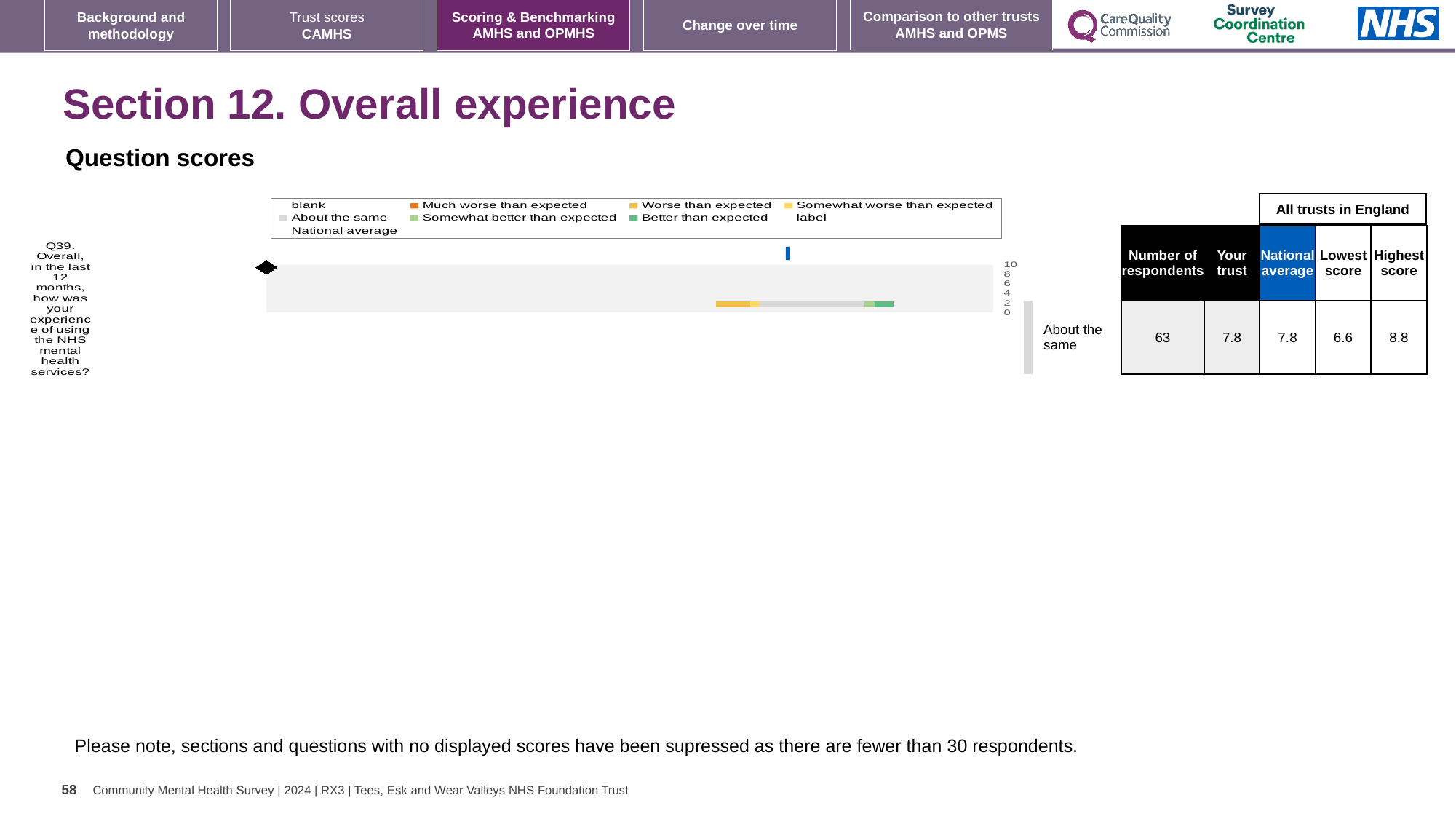
Which question number is plotted in the question scores chart? Q39 What is the national average score for Q39? 7.8 What kind of chart is used to show the Q39 question score? bar chart What is the highest score among all trusts in England for Q39? 8.8 What is the difference between the highest score and the lowest score for Q39? 2.2 How many questions are plotted in the question scores chart? 1 What is the lowest score among all trusts in England for Q39? 6.6 What benchmark category is shown next to the Q39 bar? About the same What is the 'Your trust' score for Q39? 7.8 How many respondents answered Q39? 63 Is the 'Your trust' score for Q39 higher than, lower than, or the same as the national average? the same What colour does the legend use for 'Better than expected'? green